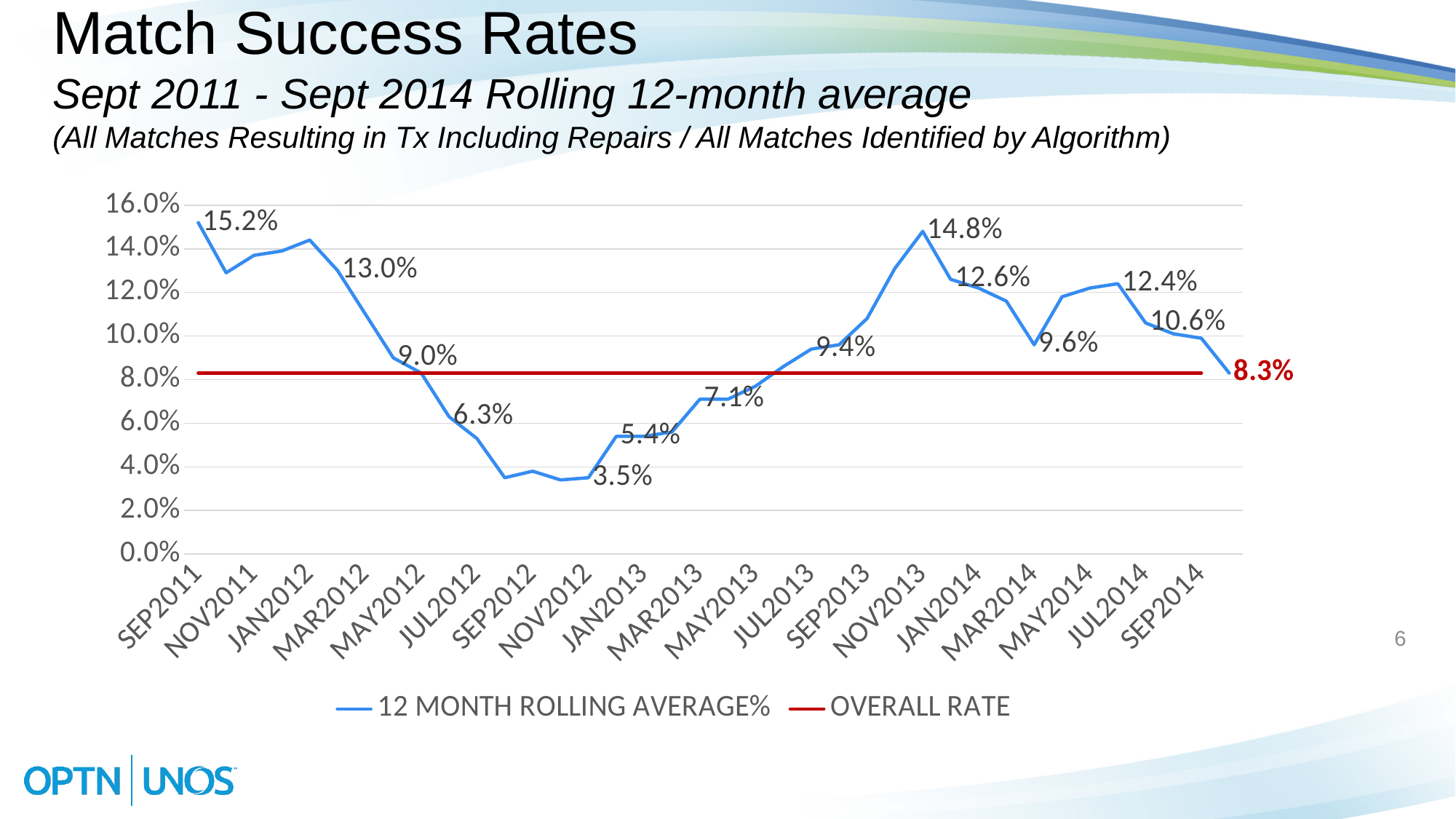
What is the overall rate shown by the red line? 8.3% Does the 12-month rolling average line rise or fall from SEP2011 to NOV2012? Fall What kind of chart is shown on the slide? Line chart How many series does the legend list? 2 What is the highest value labeled on the 12-month rolling average line? 15.2% What is the difference between the highest labeled value (15.2%) and the lowest labeled value (3.5%) on the rolling average line? 11.7 percentage points What is the 12-month rolling average value labeled at SEP2011? 15.2% What is the difference between the labeled values 14.8% and 12.6% on the rolling average line? 2.2 percentage points Which is larger, the labeled value 9.4% or the labeled value 7.1% on the rolling average line? 9.4% How many month labels are shown on the x axis? 19 Is the 12-month rolling average value at NOV2011 greater or less than 12.0%? greater What is the lowest value labeled on the 12-month rolling average line? 3.5%